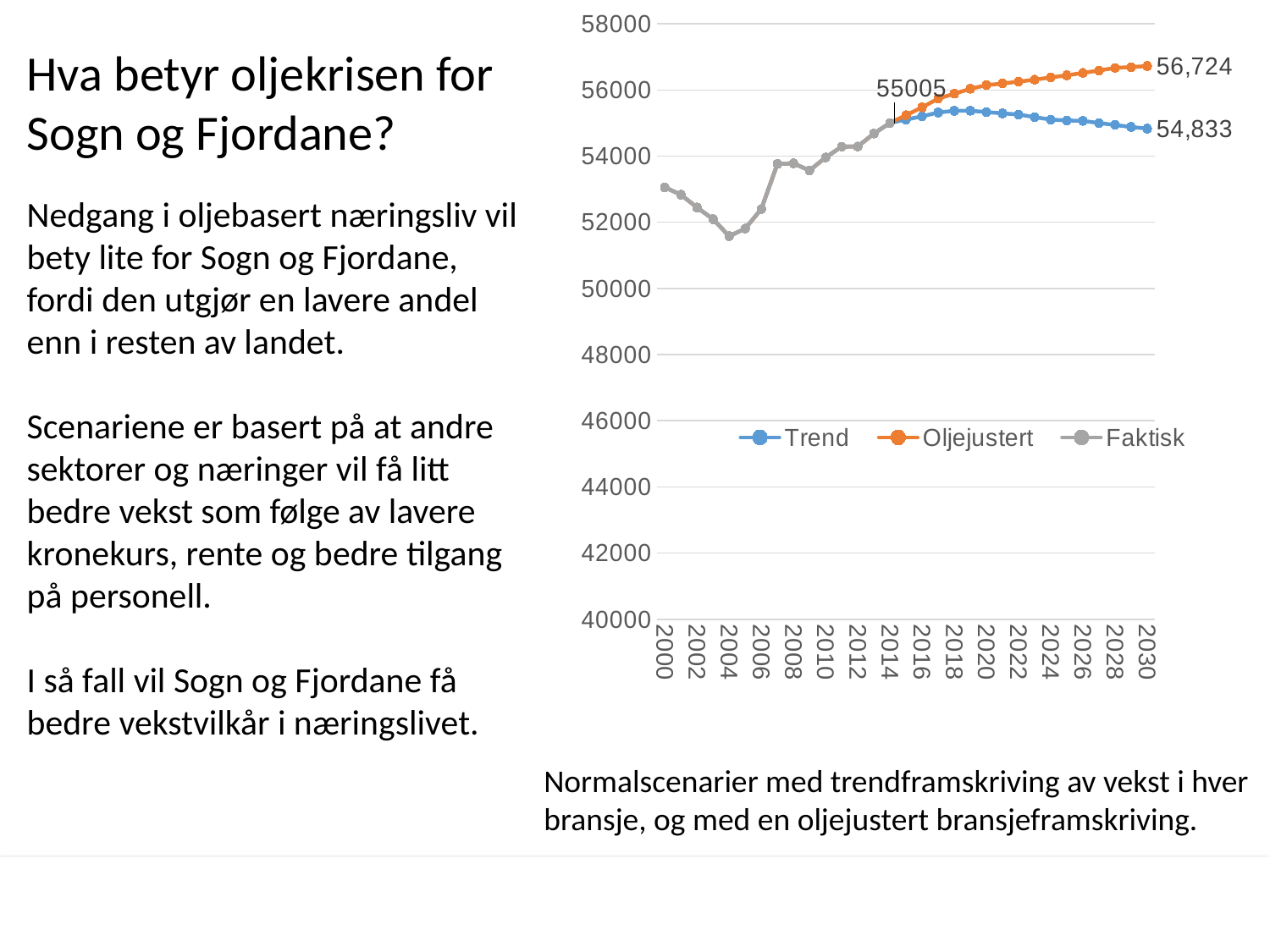
Does the Trend series rise or fall between 2020 and 2030? fall What is the difference between the Oljejustert and Trend values in 2030? 1,891 In which year does the Faktisk series reach its lowest value? 2004 What value is labelled at the point where the projections start in 2014? 55005 Which series has the higher value in 2030, Trend or Oljejustert? Oljejustert Is the value of the Faktisk series in 2000 greater or less than 52000? greater What kind of chart is shown on the slide? line chart Is the value of the Faktisk series in 2004 greater or less than 52000? less What colour is used for the Oljejustert series? orange What is the value of the Oljejustert series in 2030? 56,724 How many series does the chart legend list? 3 What is the value of the Trend series in 2030? 54,833